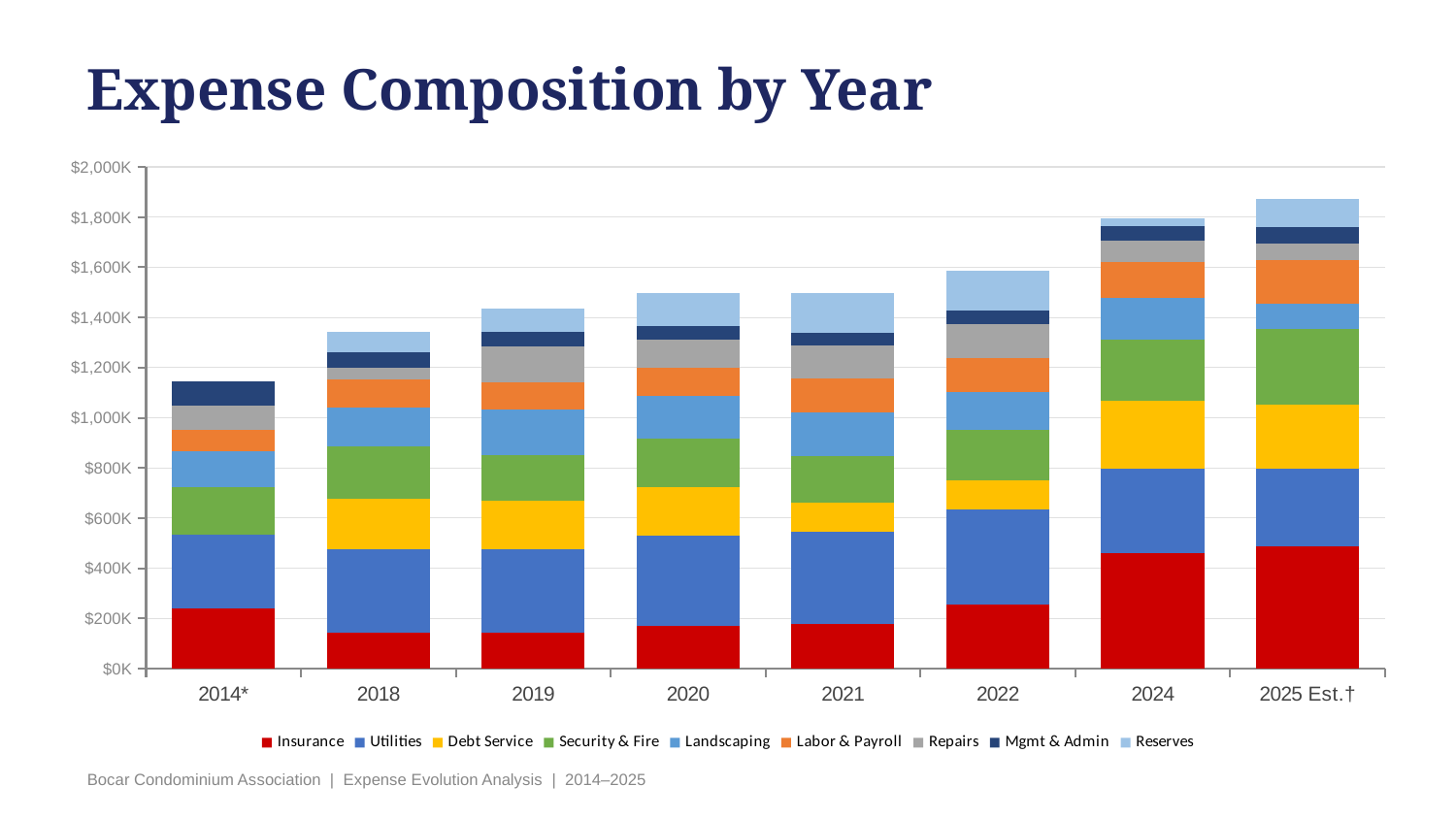
How many expense categories does the legend list? 9 Do total expenses generally rise or fall from 2014* to 2025 Est.†? rise Which year has the lowest total expenses? 2014* What kind of chart is shown on the slide? Stacked bar chart How many years (bars) are shown on the x axis? 8 Is the total expense for 2014* greater or less than $1,200K? less Is the total expense for 2024 greater or less than $1,600K? greater Which year has the larger total expenses, 2022 or 2024? 2024 Which year has the highest total expenses? 2025 Est.† Is the total expense for 2018 greater or less than $1,400K? less What is the title of the chart? Expense Composition by Year